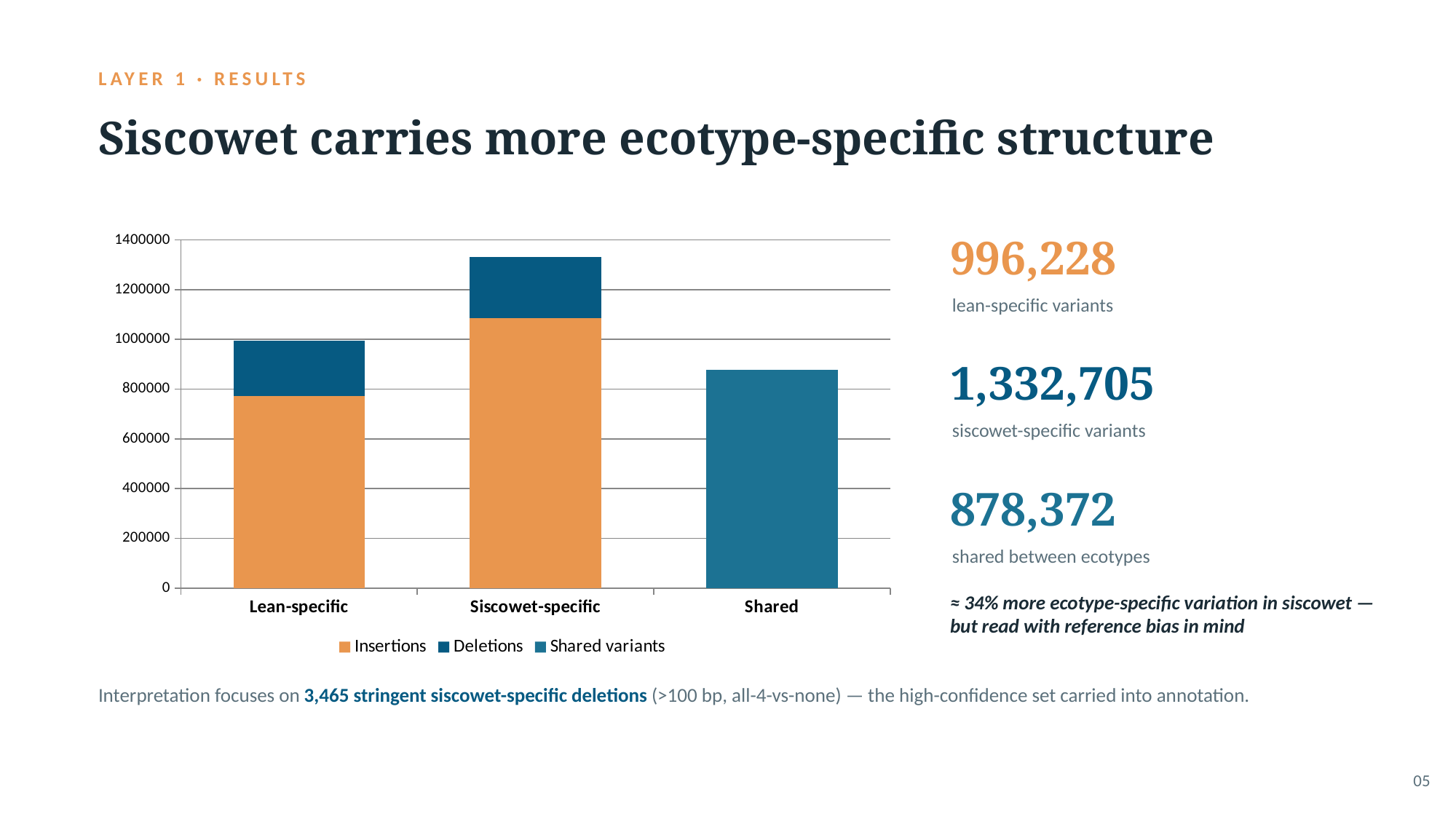
Which legend entry is shown in orange? Insertions What is the total number of siscowet-specific variants shown on the slide? 1,332,705 Which category has the shortest bar in the chart? Shared What is the total number of lean-specific variants shown on the slide? 996,228 What is the difference between the siscowet-specific total and the lean-specific total? 336,477 How many categories are shown on the x axis of the chart? 3 Is the Insertions value for Siscowet-specific greater or less than 1000000? greater Is the Insertions value for Lean-specific greater or less than 600000? greater How many series does the chart legend list? 3 What kind of chart is shown on the slide? Stacked bar chart What is the value for the Shared bar, as printed on the slide? 878,372 Which category has the tallest bar in the chart? Siscowet-specific